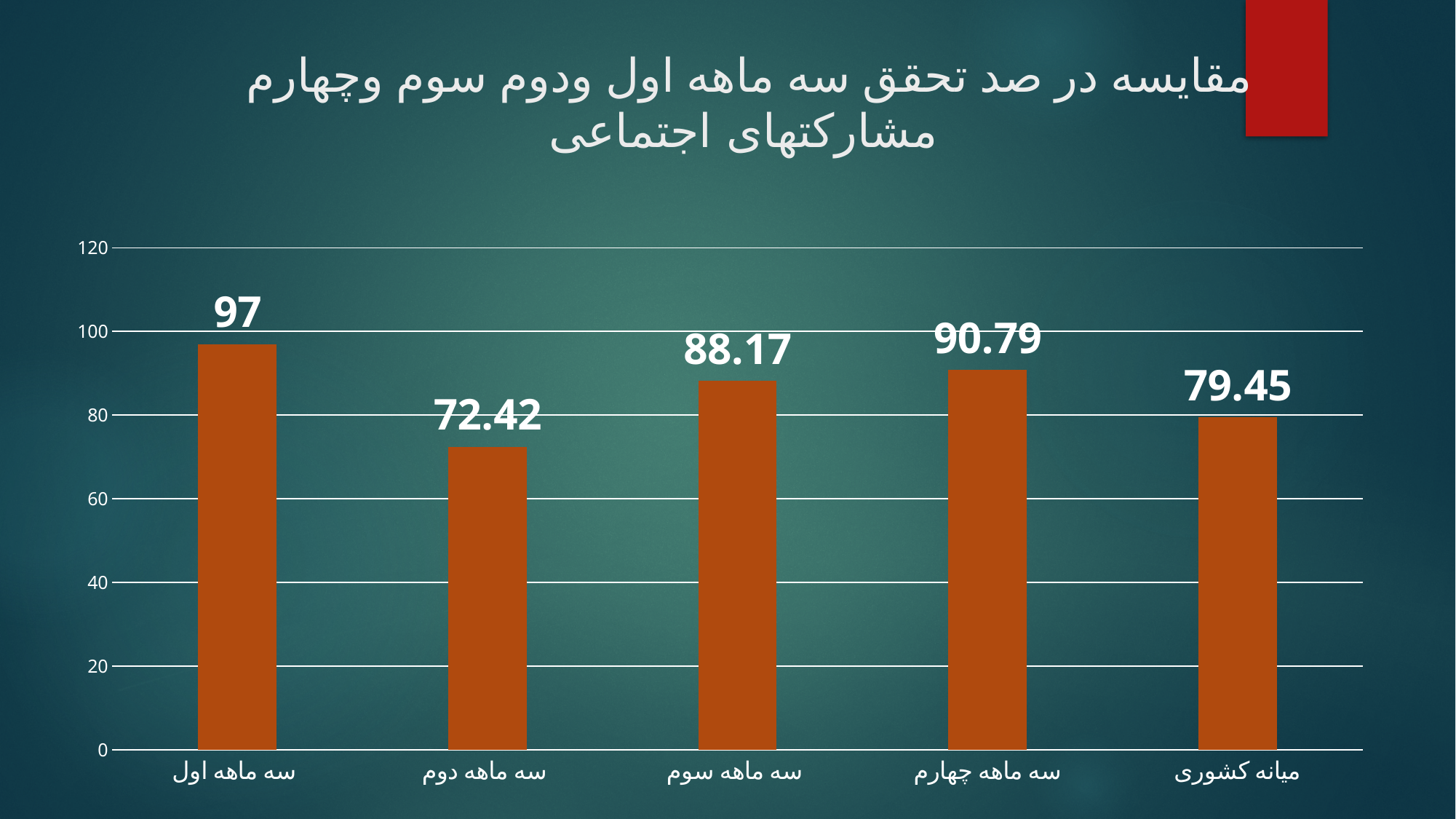
What is the difference between the values for سه ماهه چهارم and سه ماهه سوم? 2.62 What is the value for میانه کشوری? 79.45 What is the value for سه ماهه اول? 97 What is the difference between the values for سه ماهه اول and سه ماهه دوم? 24.58 Is the value for سه ماهه چهارم greater or less than 80? greater How many categories are shown on the x axis? 5 What kind of chart is shown on the slide? bar chart What is the value for سه ماهه دوم? 72.42 Which category has the lowest value? سه ماهه دوم Which category has the highest value? سه ماهه اول What is the highest value shown on the vertical axis? 120 Which is larger, the value for سه ماهه سوم or the value for میانه کشوری? سه ماهه سوم